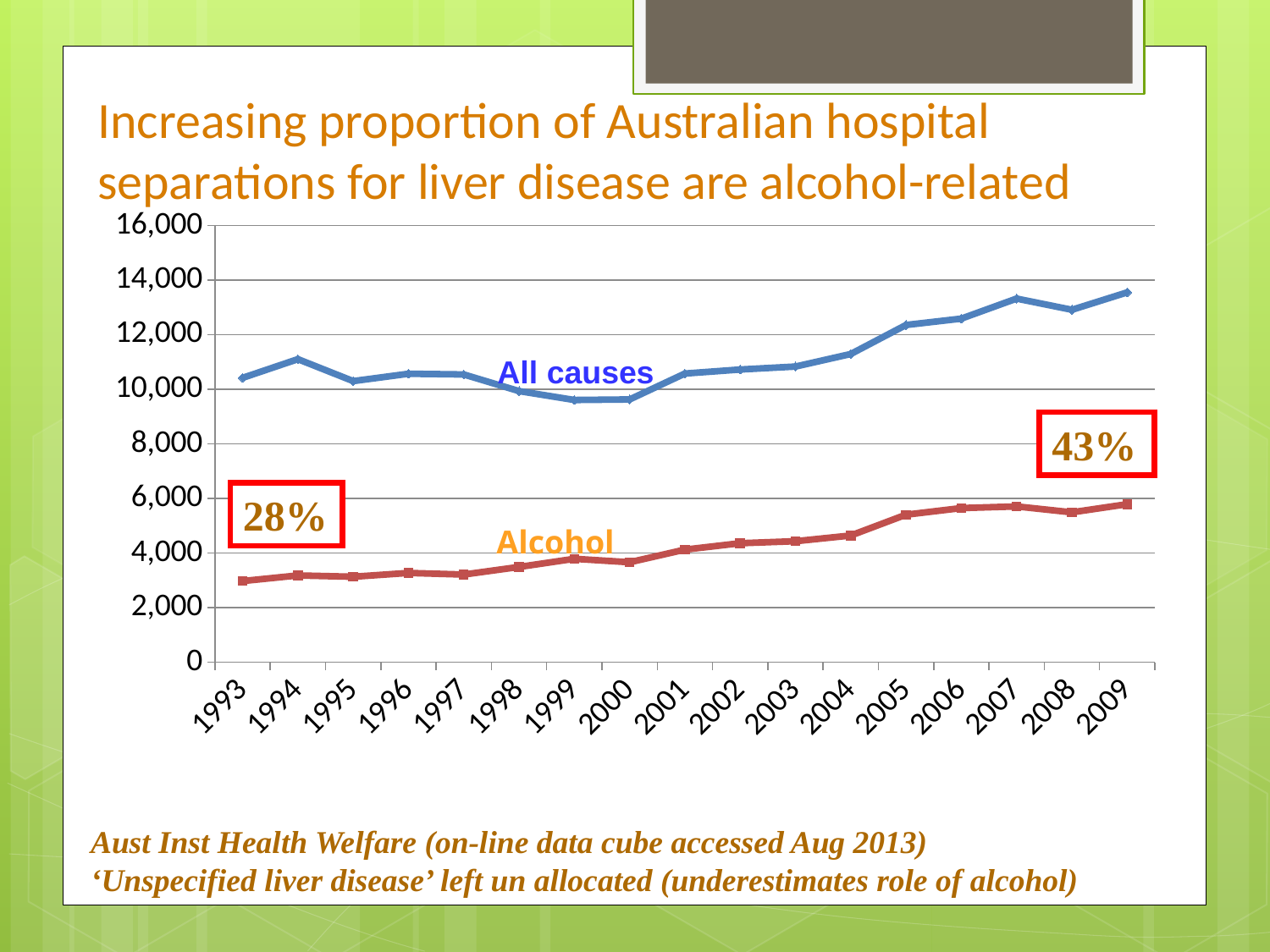
Is the value for All causes in 2007 greater or less than 12,000? greater Is the value for Alcohol in 2009 greater or less than 6,000? less Which series has the larger value in 2009, All causes or Alcohol? All causes How many years are shown along the x axis of the chart? 17 Is the value for All causes in 1993 greater or less than 10,000? greater What percentage is shown in the red box at the right end of the chart? 43% How many series are plotted on the chart? 2 What kind of chart is shown on the slide? Line chart Does the Alcohol series generally rise or fall from 1993 to 2009? Rise What is the first year shown on the x axis? 1993